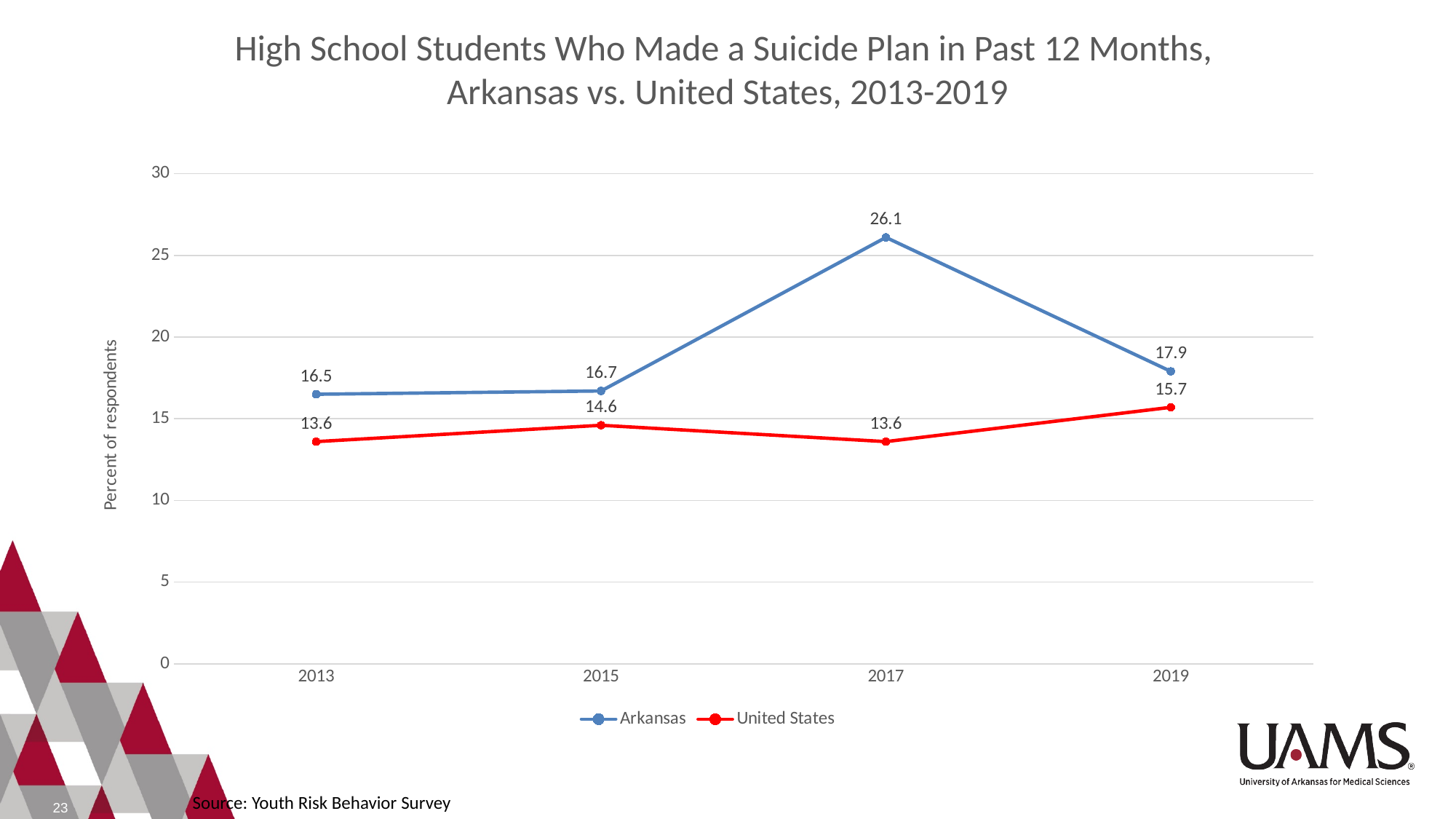
What is the difference between the Arkansas and United States values in 2017? 12.5 What was the Arkansas value in 2019? 17.9 In which year was the Arkansas value highest? 2017 How many series does the legend list? 2 In which year was the Arkansas value lowest? 2013 Which was larger in 2019, Arkansas or United States? Arkansas What was the Arkansas value in 2017? 26.1 What was the United States value in 2015? 14.6 In which year was the United States value highest? 2019 What is the label of the y axis? Percent of respondents What kind of chart is shown on the slide? Line chart How many years are shown on the x axis? 4